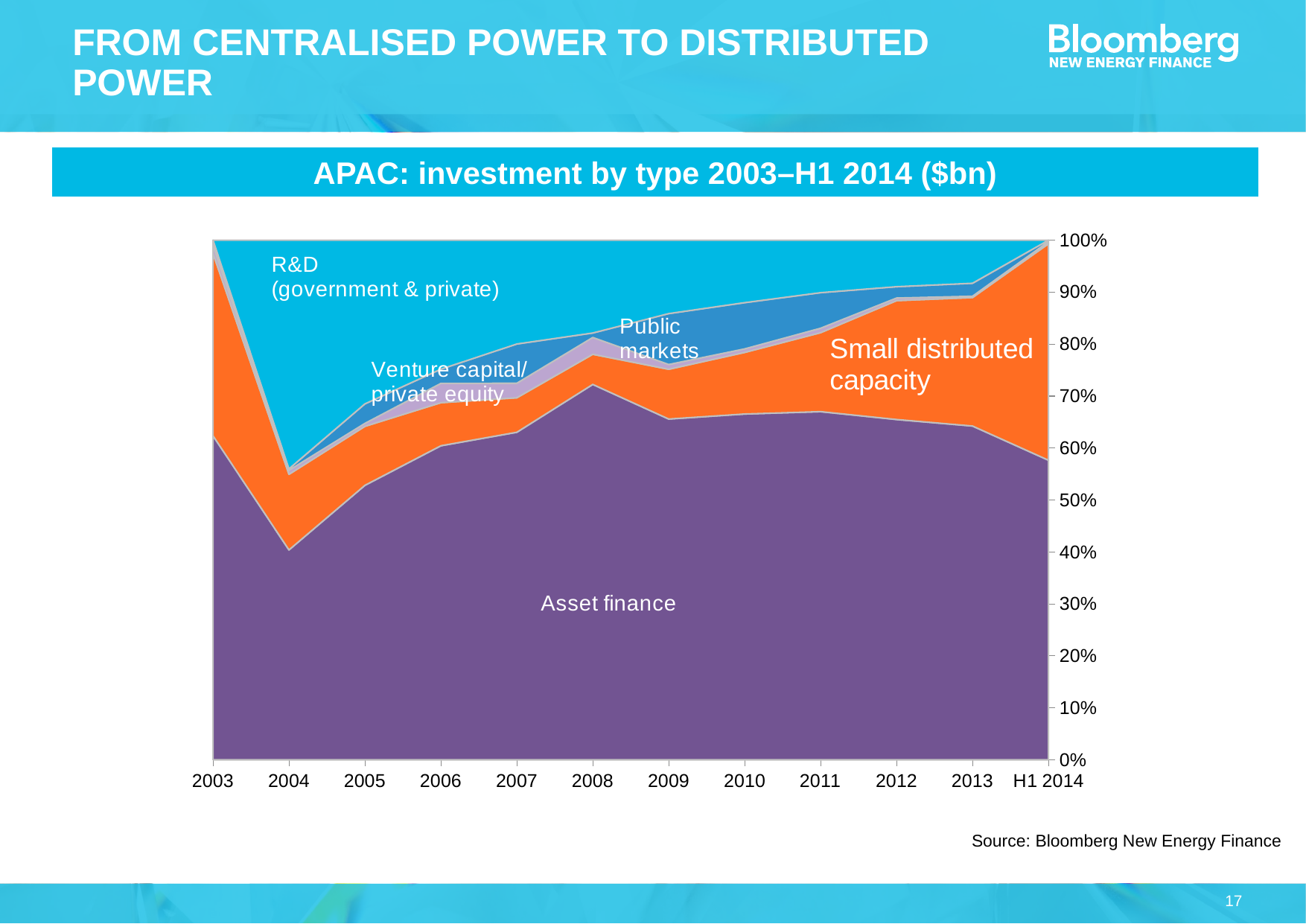
What kind of chart is shown on the slide? Stacked area chart What is the title of the chart? APAC: investment by type 2003–H1 2014 ($bn) Is the share of Asset finance in 2008 greater or less than 70%? greater Is the share of Asset finance in 2004 greater or less than 50%? less How many time periods are shown along the x axis of the chart? 12 In which year is the share of Asset finance at its highest? 2008 How many investment types (series) are labelled in the chart? 5 Does the share of Small distributed capacity rise or fall from 2011 to H1 2014? rise Is the share of Asset finance in 2011 greater or less than 60%? greater In which year is the share of Asset finance at its lowest? 2004